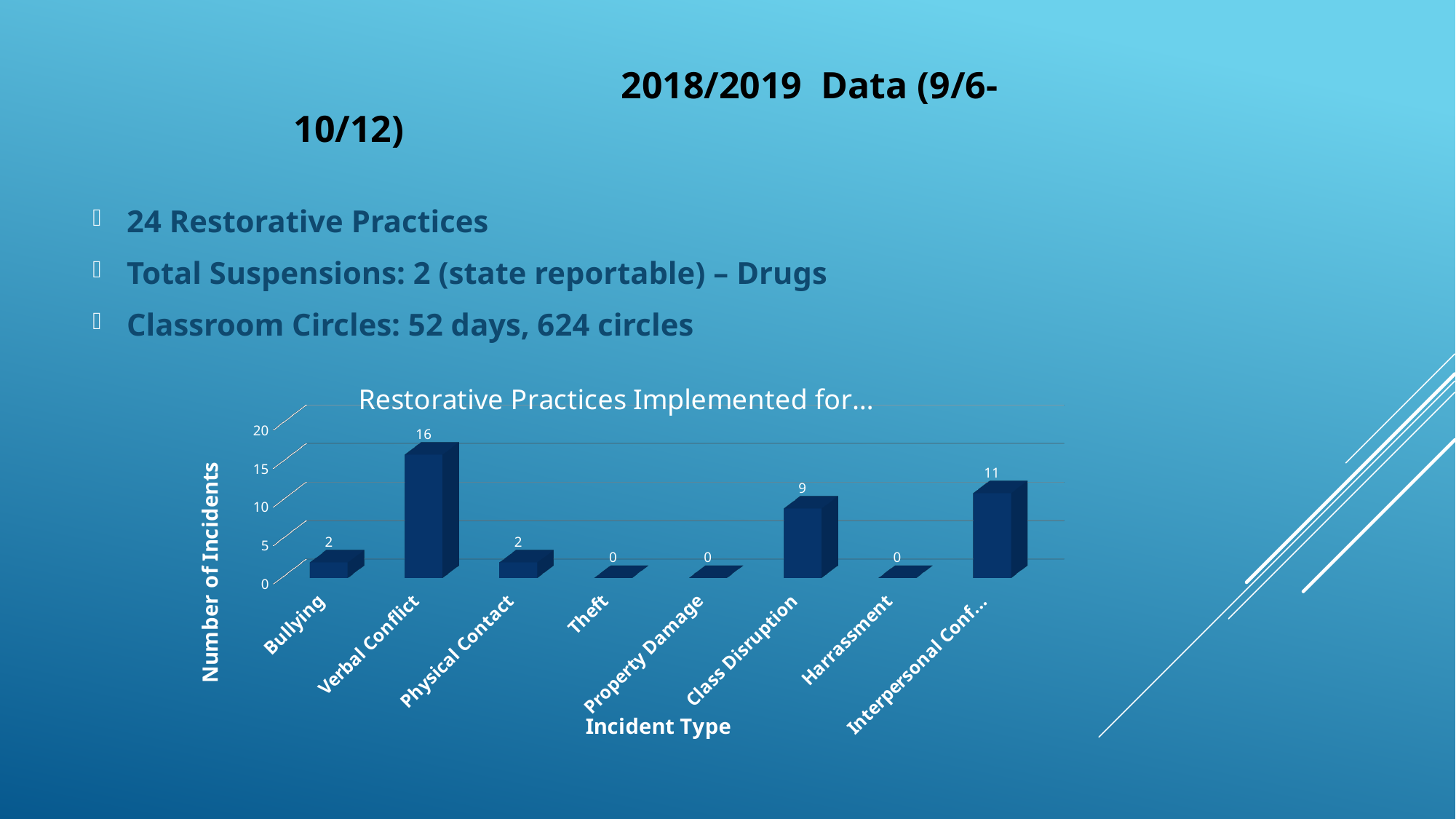
What is the label of the y axis? Number of Incidents Is the value for Verbal Conflict greater or less than 15? greater What is the difference between the values for Verbal Conflict and Class Disruption? 7 What kind of chart is shown on the slide? bar chart Which is larger, the value for Class Disruption or the value for Physical Contact? Class Disruption Which incident type has the highest number of incidents? Verbal Conflict What is the value for Theft? 0 How many incident types have a value of 0? 3 What is the value for Class Disruption? 9 How many incident types are shown on the x axis? 8 What is the value for Bullying? 2 What is the value for Verbal Conflict? 16